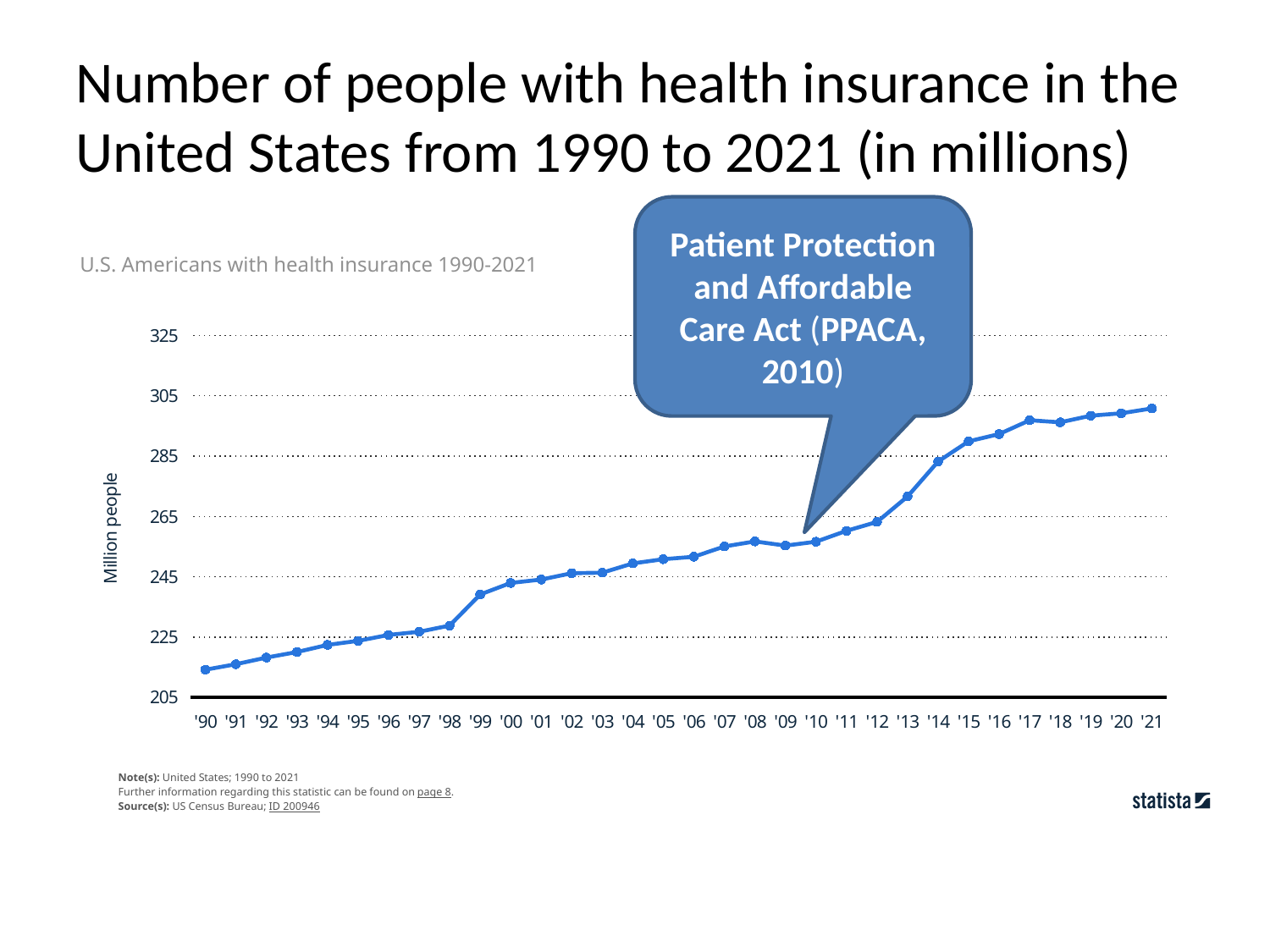
Is the value for '13 greater or less than 265? greater What is the label on the y axis? Million people Which year has the highest number of people with health insurance? '21 Is the value for '21 greater or less than 285? greater Which year has the lowest number of people with health insurance? '90 Is the value for '99 greater or less than 245? less How many years (data points) are plotted on the x axis? 32 Which year has the larger value, '13 or '09? '13 What kind of chart is shown on the slide? line chart What act does the callout on the chart refer to? Patient Protection and Affordable Care Act (PPACA, 2010) Do the values generally rise or fall from '90 to '21? rise